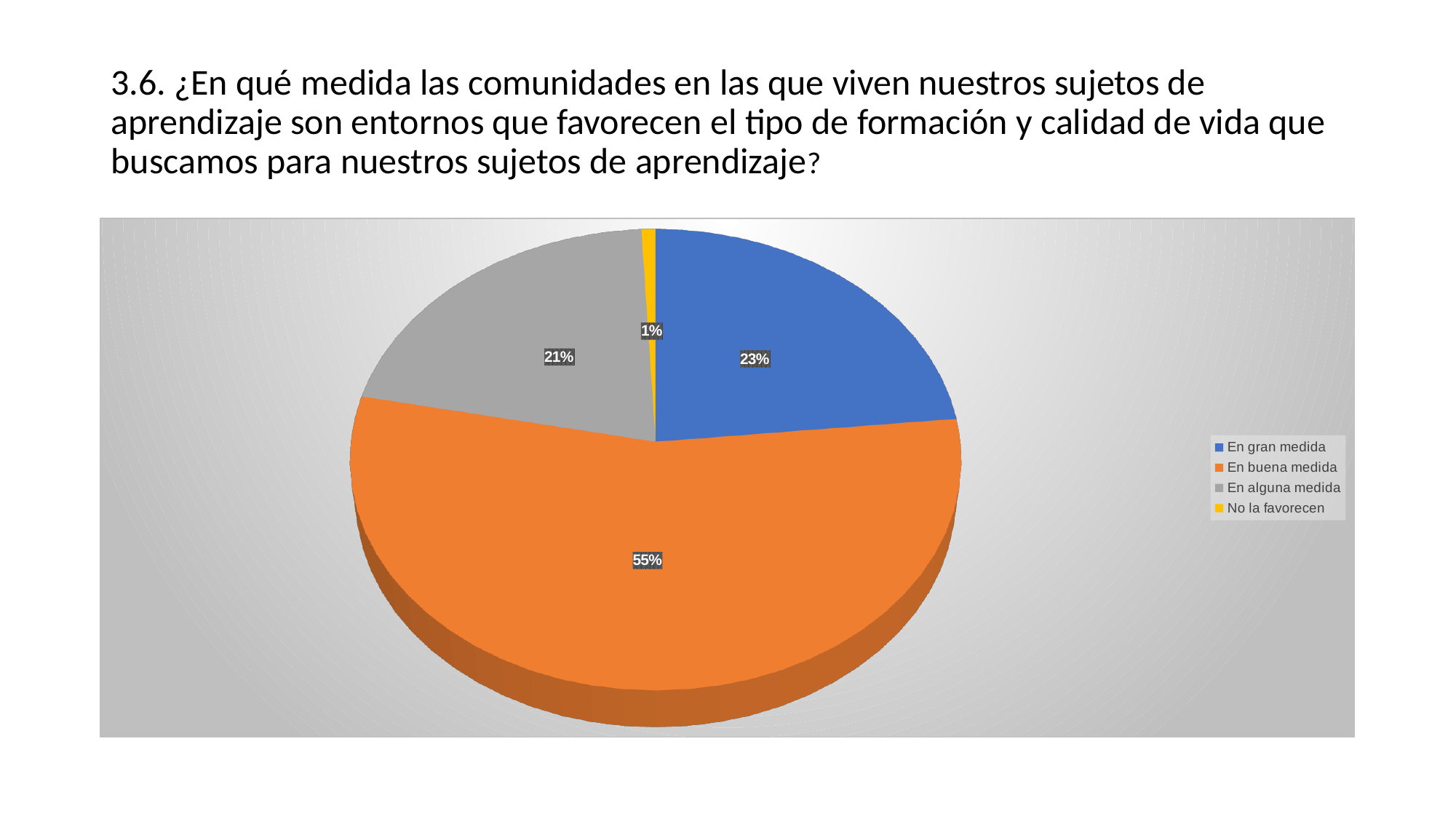
What kind of chart is shown on the slide? pie chart What colour is the slice for "En alguna medida"? grey What is the difference in percentage points between "En buena medida" and "En gran medida"? 32 Which is larger, the share for "En gran medida" or the share for "En alguna medida"? En gran medida What percentage of the pie corresponds to "No la favorecen"? 1% What percentage of the pie corresponds to "En alguna medida"? 21% Which category has the smallest share of the pie? No la favorecen Which category has the largest share of the pie? En buena medida Which legend entry is shown in yellow? No la favorecen What percentage of the pie corresponds to "En gran medida"? 23% How many categories does the pie chart have? 4 What percentage of the pie corresponds to "En buena medida"? 55%